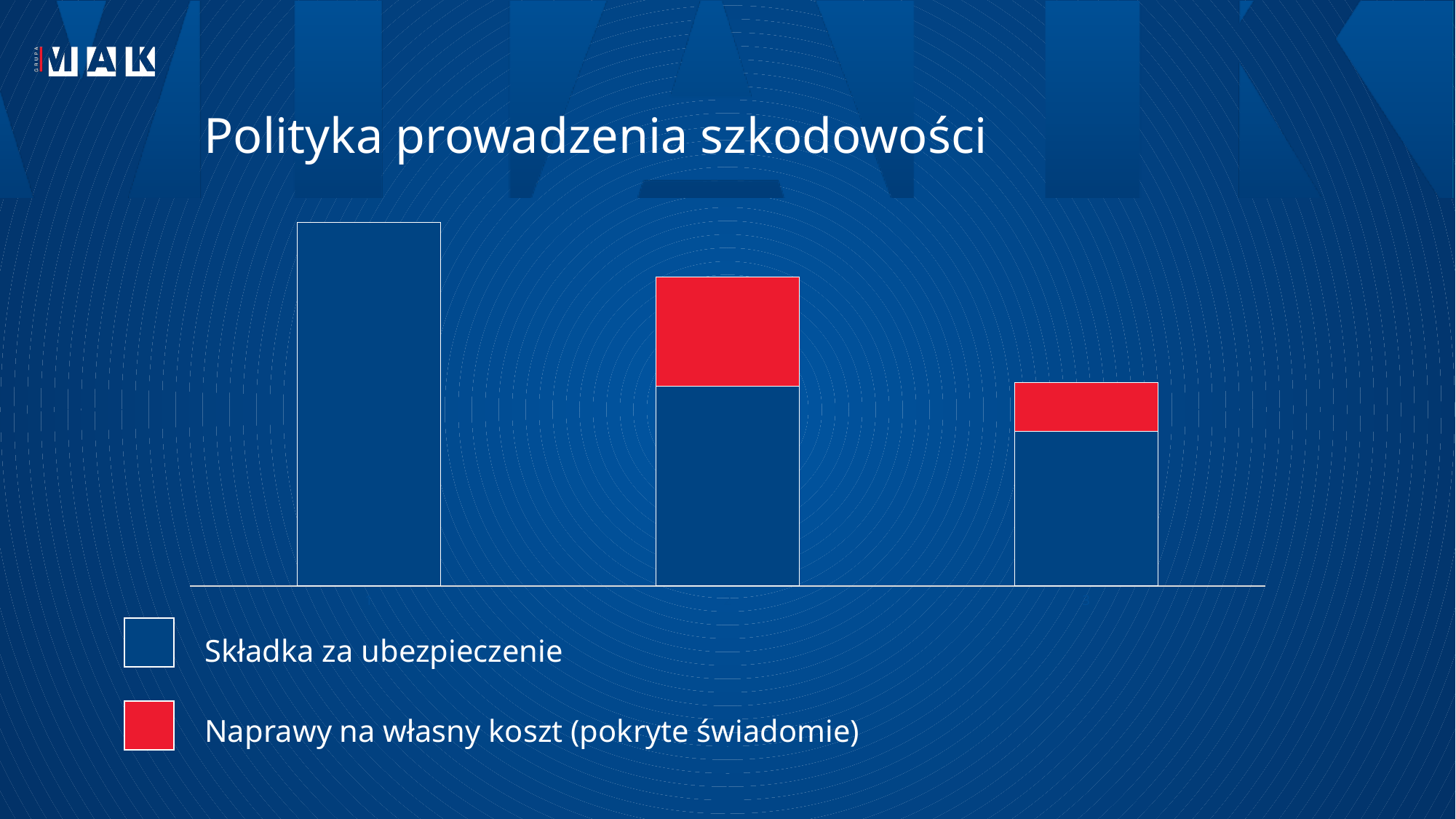
Which bar has the larger blue segment (Składka za ubezpieczenie): the left or the right one? left Which bar is the shortest overall: the left, middle or right one? right What is the title of the slide containing the chart? Polityka prowadzenia szkodowości What kind of chart is shown on the slide? bar chart Which bar is the tallest overall: the left, middle or right one? left How many series does the legend list? 2 Do the total bar heights rise or fall from left to right? fall How many bars does the chart contain? 3 Which bar has the larger red segment (Naprawy na własny koszt): the middle or the right one? middle Which bar contains no red segment: the left, middle or right one? left Which legend entry is shown in red? Naprawy na własny koszt (pokryte świadomie)